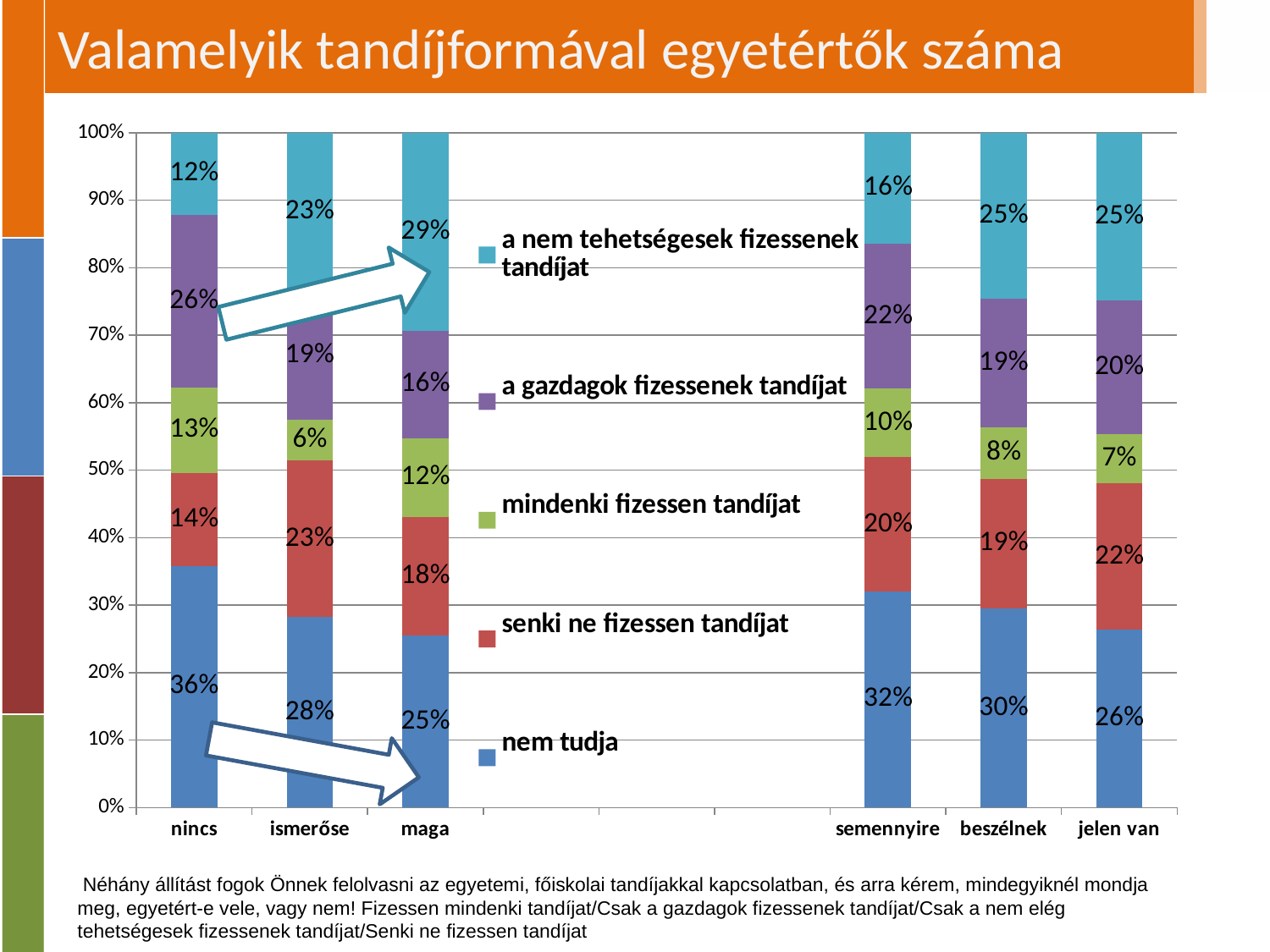
Which category has the lowest value for "a nem tehetségesek fizessenek tandíjat"? nincs What is the value of "senki ne fizessen tandíjat" for the category "jelen van"? 22% How many categories are shown on the x axis? 6 What kind of chart is shown on the slide? stacked bar chart What is the difference between the "a gazdagok fizessenek tandíjat" values for "nincs" and "maga"? 10% What is the title of the chart? Valamelyik tandíjformával egyetértők száma What is the value of "nem tudja" for the category "nincs"? 36% How many series does the legend list? 5 Which category has the highest value for "nem tudja"? nincs What is the value of "a nem tehetségesek fizessenek tandíjat" for the category "maga"? 29% What is the value of "mindenki fizessen tandíjat" for the category "ismerőse"? 6% Which is larger: the "senki ne fizessen tandíjat" value for "ismerőse" or for "nincs"? ismerőse